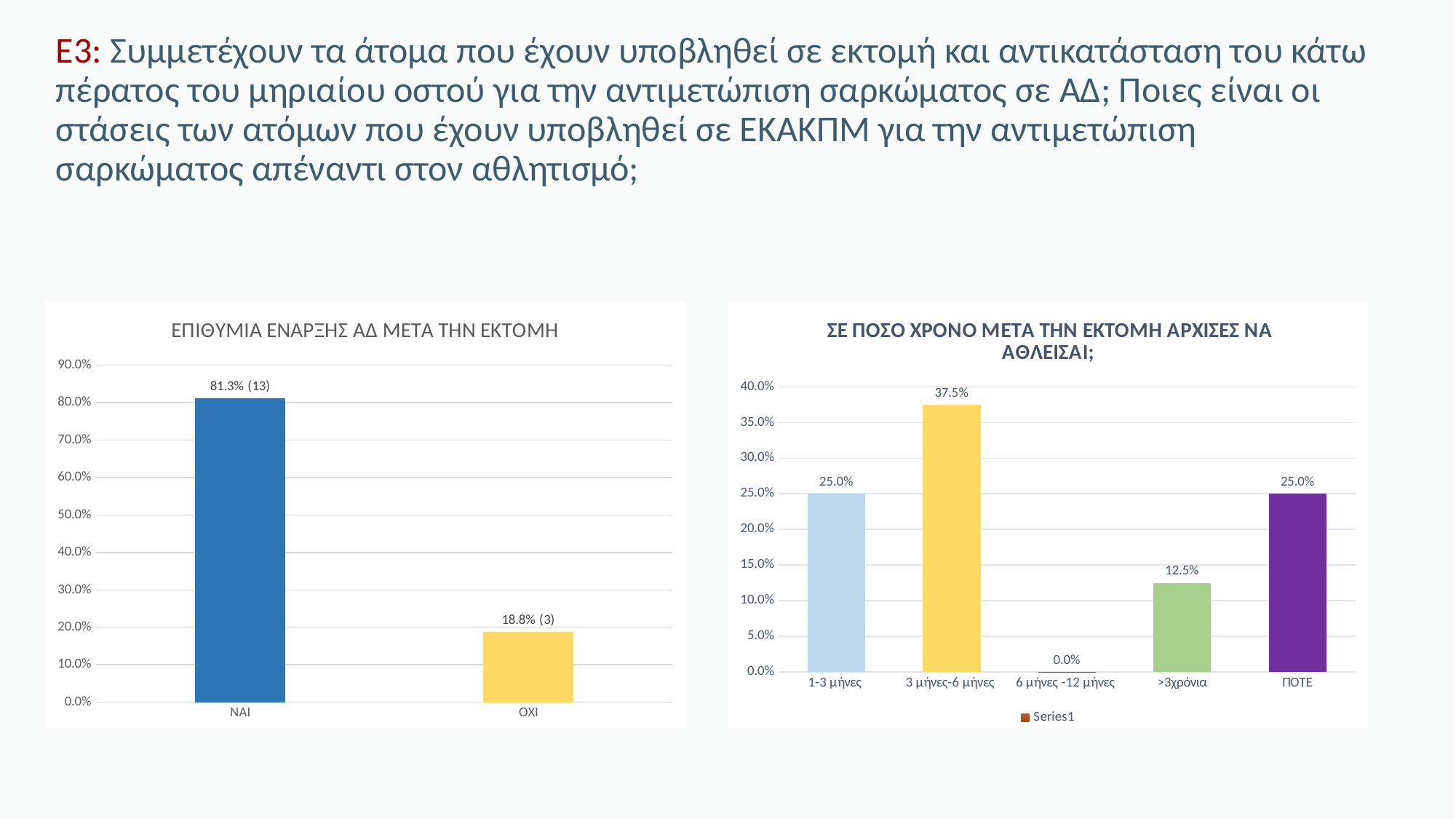
In the right chart (ΣΕ ΠΟΣΟ ΧΡΟΝΟ ΜΕΤΑ ΤΗΝ ΕΚΤΟΜΗ ΑΡΧΙΣΕΣ ΝΑ ΑΘΛΕΙΣΑΙ;), which category has the lowest value? 6 μήνες -12 μήνες In the left chart (ΕΠΙΘΥΜΙΑ ΕΝΑΡΞΗΣ ΑΔ ΜΕΤΑ ΤΗΝ ΕΚΤΟΜΗ), what is the difference in percentage points between ΝΑΙ and ΟΧΙ? 62.5 In the right chart (ΣΕ ΠΟΣΟ ΧΡΟΝΟ ΜΕΤΑ ΤΗΝ ΕΚΤΟΜΗ ΑΡΧΙΣΕΣ ΝΑ ΑΘΛΕΙΣΑΙ;), what is the value for 3 μήνες-6 μήνες? 37.5% In the right chart (ΣΕ ΠΟΣΟ ΧΡΟΝΟ ΜΕΤΑ ΤΗΝ ΕΚΤΟΜΗ ΑΡΧΙΣΕΣ ΝΑ ΑΘΛΕΙΣΑΙ;), which category has the highest value? 3 μήνες-6 μήνες In the left chart (ΕΠΙΘΥΜΙΑ ΕΝΑΡΞΗΣ ΑΔ ΜΕΤΑ ΤΗΝ ΕΚΤΟΜΗ), how many categories are shown? 2 What kind of chart is the left chart (ΕΠΙΘΥΜΙΑ ΕΝΑΡΞΗΣ ΑΔ ΜΕΤΑ ΤΗΝ ΕΚΤΟΜΗ)? Bar chart In the left chart (ΕΠΙΘΥΜΙΑ ΕΝΑΡΞΗΣ ΑΔ ΜΕΤΑ ΤΗΝ ΕΚΤΟΜΗ), what is the value for ΟΧΙ? 18.8% (3) In the right chart (ΣΕ ΠΟΣΟ ΧΡΟΝΟ ΜΕΤΑ ΤΗΝ ΕΚΤΟΜΗ ΑΡΧΙΣΕΣ ΝΑ ΑΘΛΕΙΣΑΙ;), what is the value for >3χρόνια? 12.5% In the left chart (ΕΠΙΘΥΜΙΑ ΕΝΑΡΞΗΣ ΑΔ ΜΕΤΑ ΤΗΝ ΕΚΤΟΜΗ), what is the value for ΝΑΙ? 81.3% (13) In the right chart (ΣΕ ΠΟΣΟ ΧΡΟΝΟ ΜΕΤΑ ΤΗΝ ΕΚΤΟΜΗ ΑΡΧΙΣΕΣ ΝΑ ΑΘΛΕΙΣΑΙ;), what is the difference in percentage points between 3 μήνες-6 μήνες and ΠΟΤΕ? 12.5 In the right chart (ΣΕ ΠΟΣΟ ΧΡΟΝΟ ΜΕΤΑ ΤΗΝ ΕΚΤΟΜΗ ΑΡΧΙΣΕΣ ΝΑ ΑΘΛΕΙΣΑΙ;), how many categories are shown on the x axis? 5 In the left chart (ΕΠΙΘΥΜΙΑ ΕΝΑΡΞΗΣ ΑΔ ΜΕΤΑ ΤΗΝ ΕΚΤΟΜΗ), which category has the higher value? ΝΑΙ